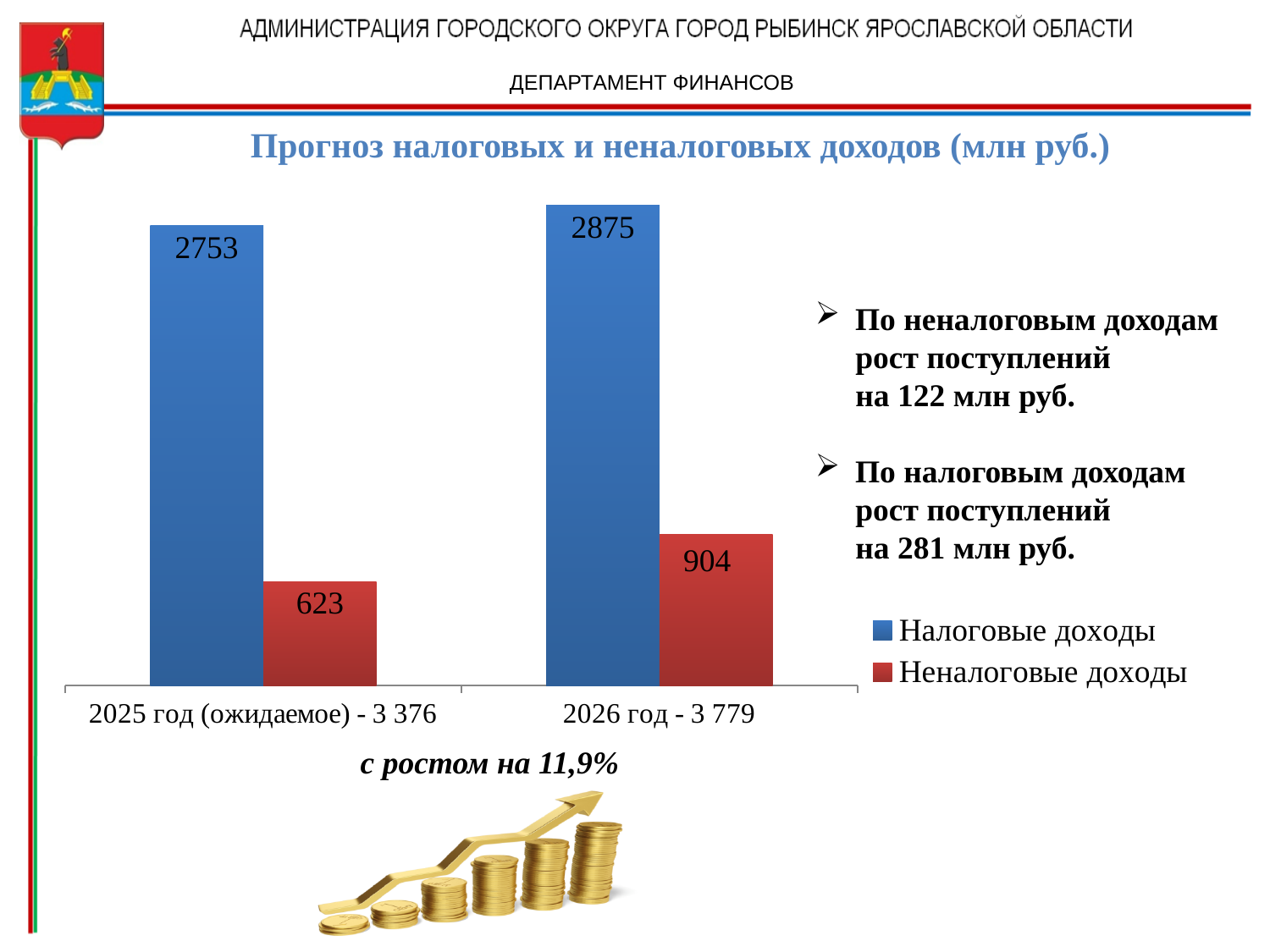
What is the title of the chart? Прогноз налоговых и неналоговых доходов (млн руб.) How many series does the legend list? 2 What is the value of Налоговые доходы for 2025 год (ожидаемое)? 2753 What is the difference between Налоговые доходы in 2026 год and in 2025 год (ожидаемое)? 122 Which category has the lowest value for Неналоговые доходы? 2025 год (ожидаемое) What is the value of Неналоговые доходы for 2026 год? 904 What is the difference between Неналоговые доходы in 2026 год and in 2025 год (ожидаемое)? 281 What is the value of Налоговые доходы for 2026 год? 2875 Which is larger: Налоговые доходы in 2025 год (ожидаемое) or Неналоговые доходы in 2026 год? Налоговые доходы in 2025 год (ожидаемое) What is the value of Неналоговые доходы for 2025 год (ожидаемое)? 623 Which category has the highest value for Налоговые доходы? 2026 год What kind of chart is shown on the slide? Bar chart